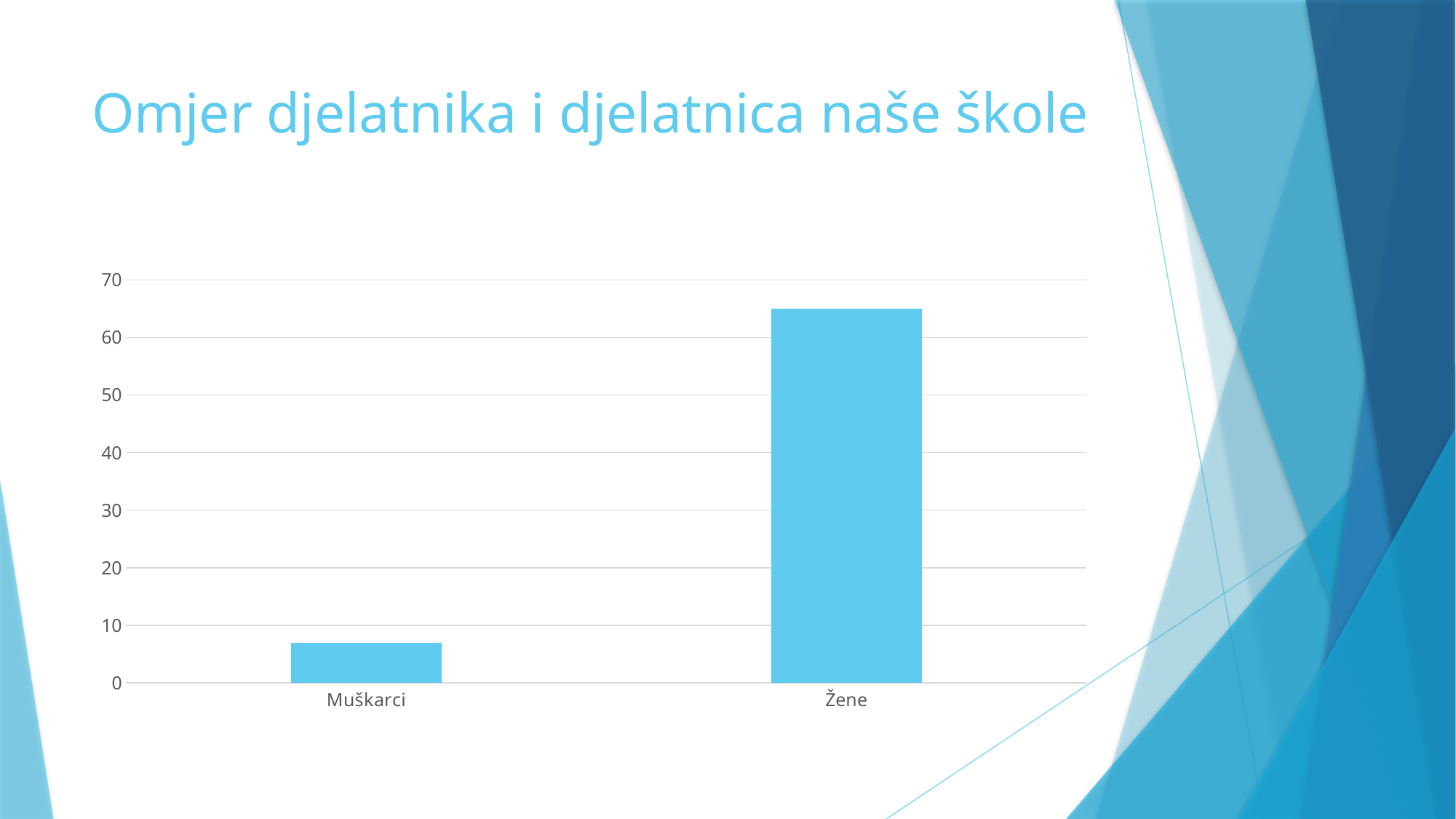
Is the value for Žene greater or less than 60? greater Is the value for Muškarci greater or less than 10? less Is the value for Muškarci greater or less than 20? less Do the bar values rise or fall from left to right along the x axis? rise What is the highest value shown on the vertical axis of the chart? 70 Which is larger, the value for Muškarci or the value for Žene? Žene What kind of chart is shown on the slide? bar chart Which category has the highest bar? Žene Which category has the lowest bar? Muškarci How many categories are shown on the x axis of the chart? 2 What is the title of the slide containing the chart? Omjer djelatnika i djelatnica naše škole